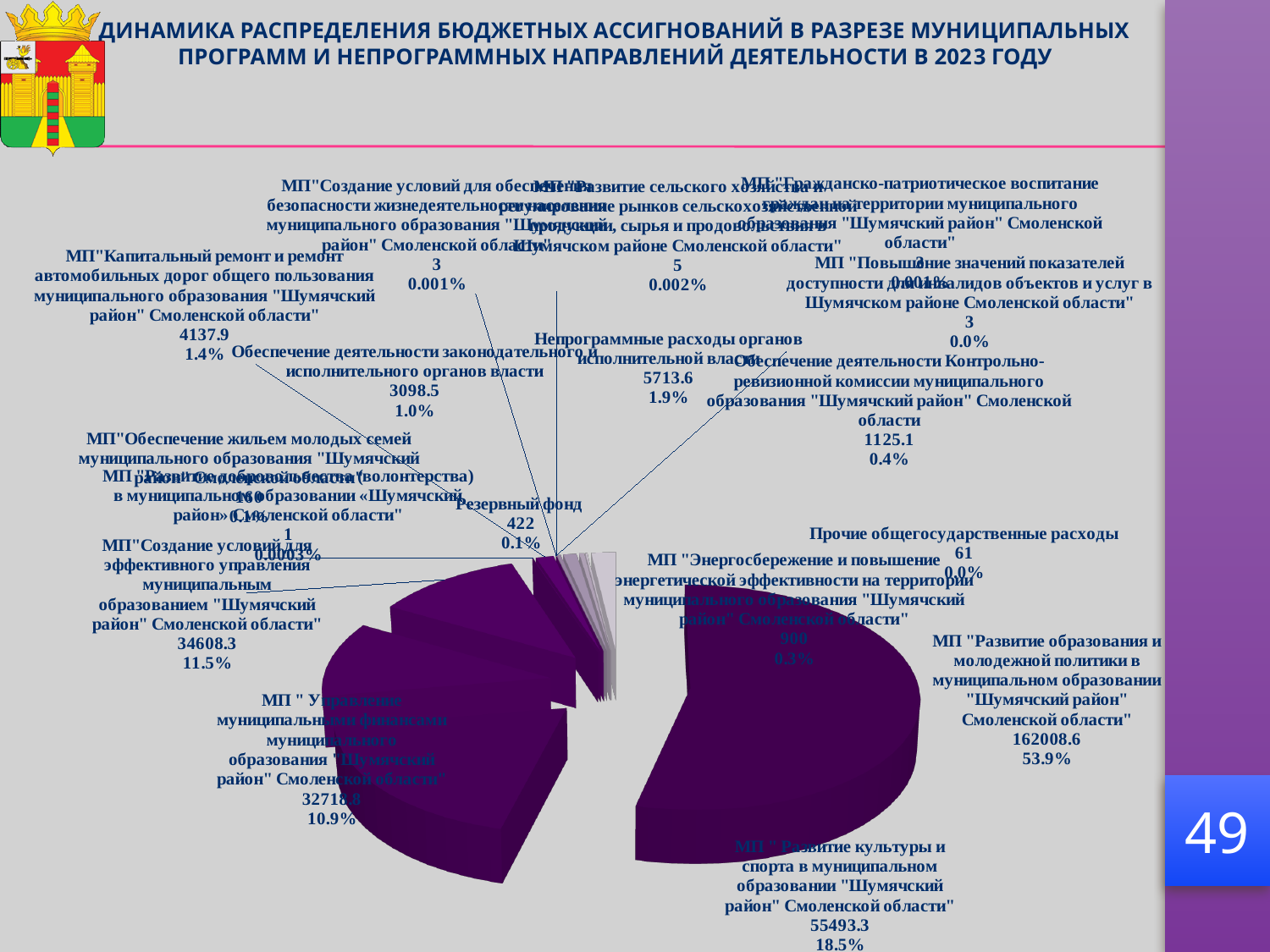
What value is shown for Обеспечение деятельности Контрольно-ревизионной комиссии муниципального образования? 1125.1 What share of the pie does МП "Развитие культуры и спорта" hold? 18.5% Which is larger: the value for МП "Развитие культуры и спорта" or the value for МП "Создание условий для эффективного управления муниципальным образованием"? МП "Развитие культуры и спорта" Which category has the largest share of the pie? МП "Развитие образования и молодежной политики в муниципальном образовании "Шумячский район" Смоленской области" What value is shown for Непрограммные расходы органов исполнительной власти? 5713.6 What value is shown for МП "Создание условий для эффективного управления муниципальным образованием"? 34608.3 What kind of chart is shown on the slide? pie chart What value is shown for Резервный фонд? 422 What is the difference between the values for МП "Развитие образования и молодежной политики" and МП "Развитие культуры и спорта"? 106515.3 What share of the pie does МП "Развитие образования и молодежной политики" hold? 53.9% What share of the pie does МП "Капитальный ремонт и ремонт автомобильных дорог общего пользования" hold? 1.4% What value is shown for МП "Развитие культуры и спорта в муниципальном образовании "Шумячский район" Смоленской области"? 55493.3